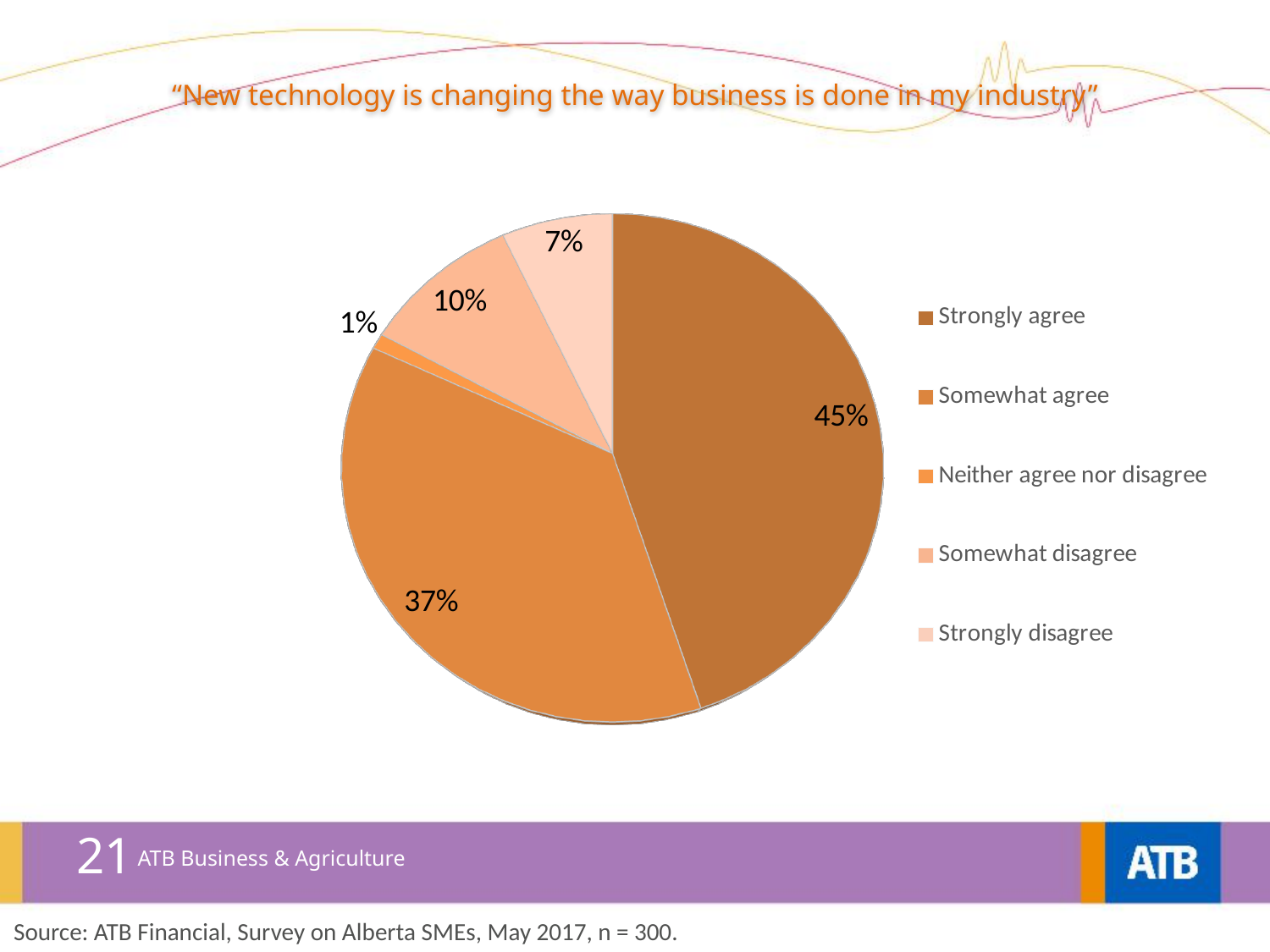
How many slices does the pie chart have? 5 What type of chart is shown on the slide? Pie chart What percentage of respondents somewhat disagree? 10% What percentage of respondents somewhat agree? 37% Which is larger: the share for 'Somewhat disagree' or the share for 'Strongly disagree'? Somewhat disagree What percentage of respondents strongly disagree? 7% What is the combined share of respondents who strongly agree or somewhat agree? 82% What share of respondents strongly agree that new technology is changing the way business is done in their industry? 45% Which response category has the smallest share of the pie? Neither agree nor disagree Which response category has the largest share of the pie? Strongly agree What percentage of respondents neither agree nor disagree? 1% How many percentage points larger is the 'Strongly agree' share than the 'Somewhat agree' share? 8